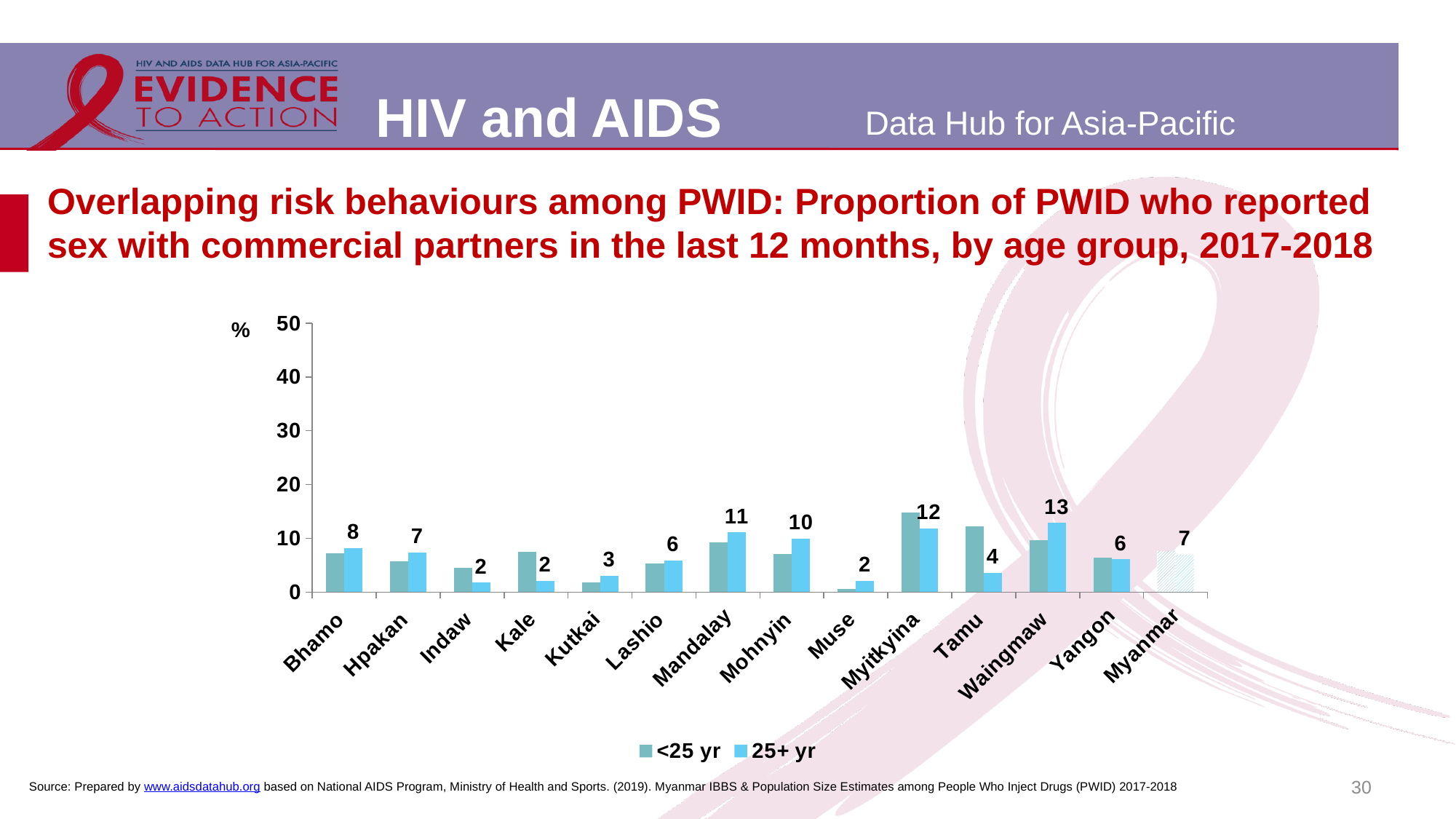
What is the value shown for Myanmar overall? 7 What is the value for the 25+ yr group in Kutkai? 3 Is the value for the <25 yr group in Myitkyina greater or less than 10? greater What is the difference between the 25+ yr values for Waingmaw and Tamu? 9 For the 25+ yr group, which is larger: Mandalay or Mohnyin? Mandalay How many sites (categories) are shown on the x axis? 14 What kind of chart is shown on the slide? Bar chart How many series does the legend list? 2 What is the value for the 25+ yr group in Waingmaw? 13 Is the value for the <25 yr group in Muse greater or less than 10? less Which site has the highest value for the 25+ yr group? Waingmaw What is the value for the 25+ yr group in Mandalay? 11